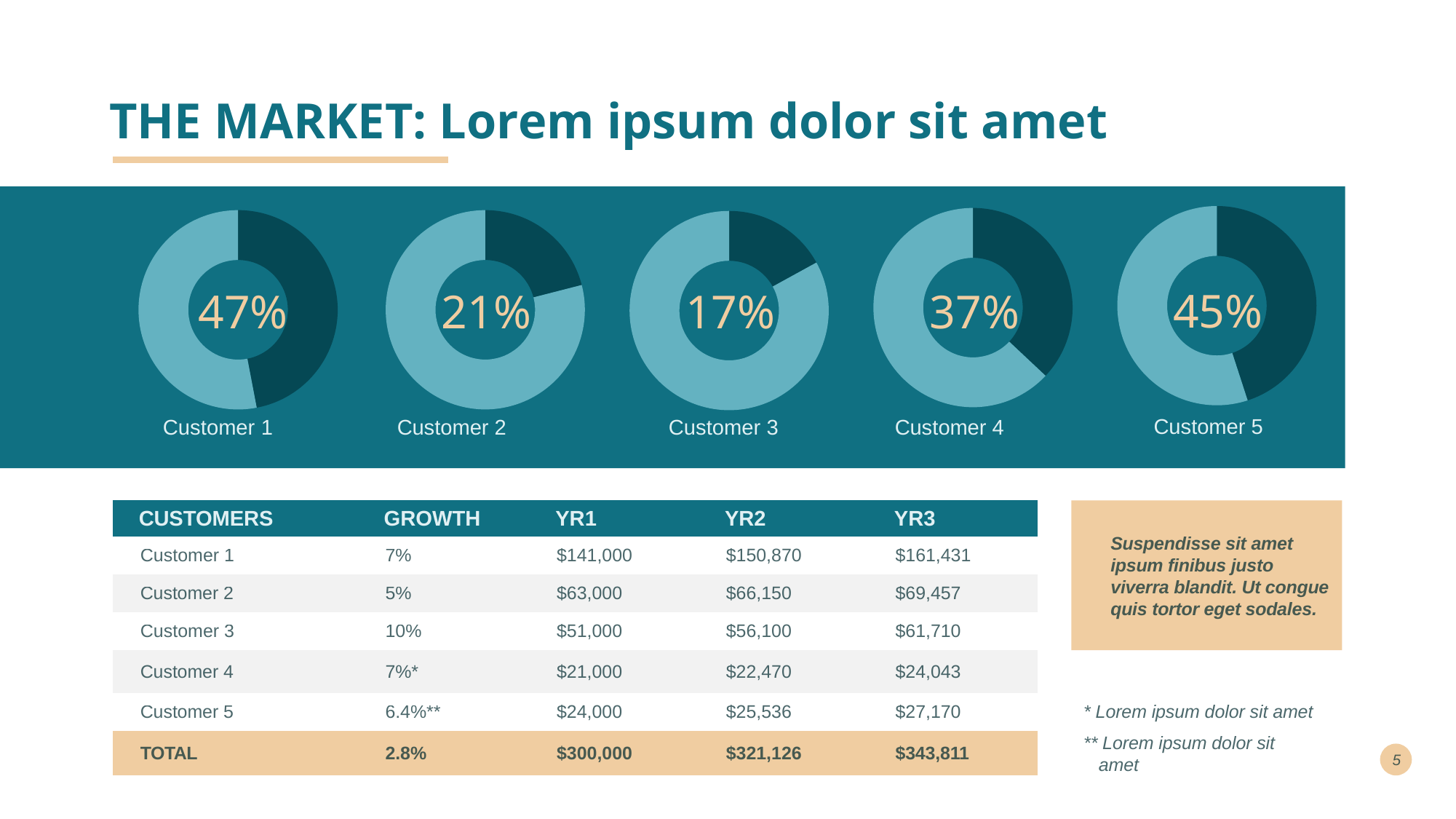
Which shows a larger percentage, the Customer 4 donut chart or the Customer 2 donut chart? Customer 4 How many donut charts are shown on the slide? 5 What percentage is shown in the Customer 1 donut chart? 47% Which customer's donut chart shows the lowest percentage? Customer 3 What percentage is shown in the Customer 5 donut chart? 45% What kind of chart is used to show the percentage for each customer? Donut chart Which customer's donut chart shows the highest percentage? Customer 1 What percentage is shown in the Customer 4 donut chart? 37% What percentage is shown in the Customer 3 donut chart? 17% What percentage is shown in the Customer 2 donut chart? 21% What is the difference between the percentages shown for Customer 1 and Customer 3? 30% What is the difference between the percentages shown for Customer 5 and Customer 4? 8%